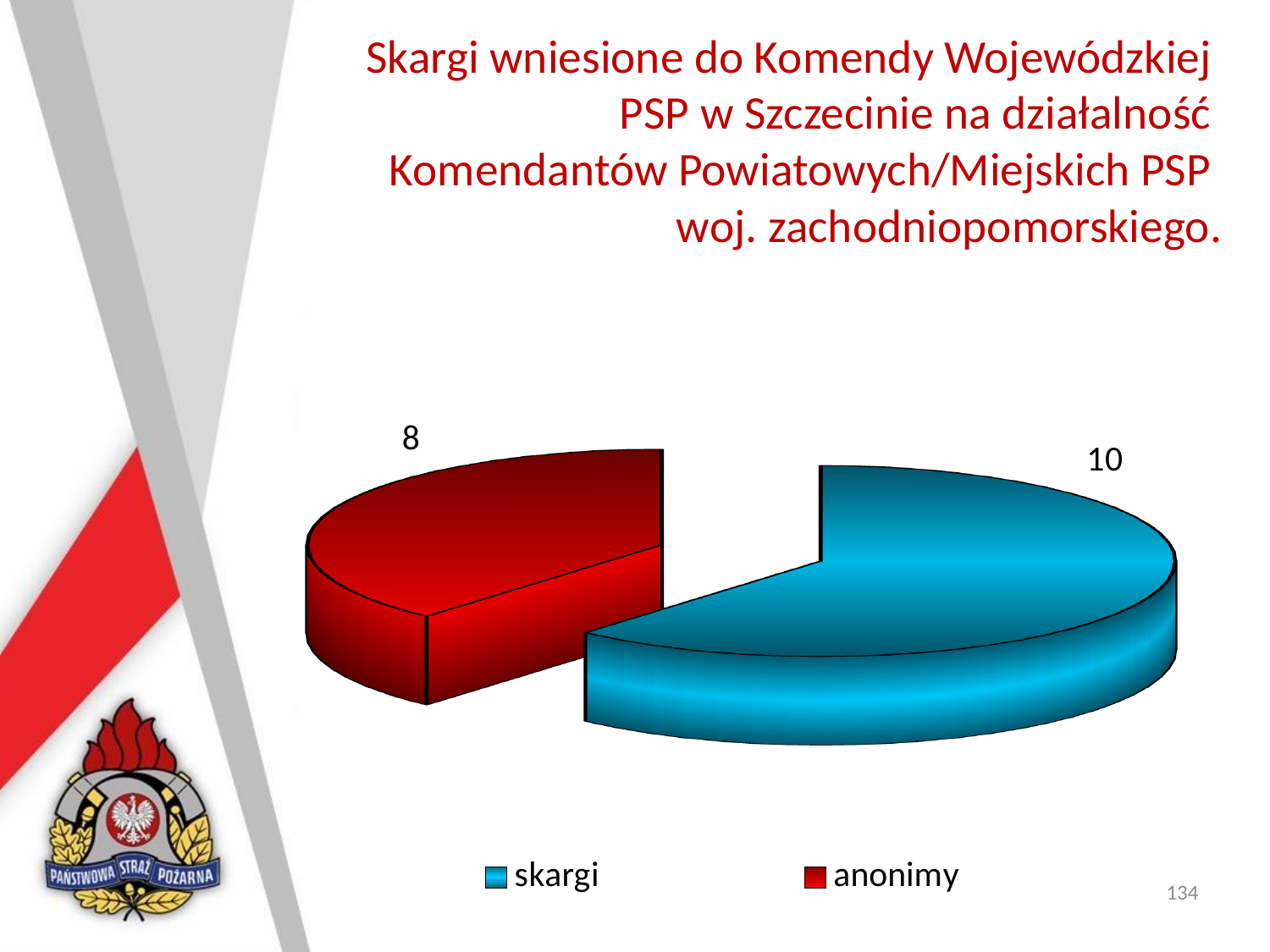
Which is larger, skargi or anonimy? skargi What is the difference between the values for skargi and anonimy? 2 How many slices does the pie chart have? 2 What colour is the slice for anonimy? red What is the value for skargi? 10 Which category has the largest slice? skargi How many entries does the legend list? 2 What colour is the slice for skargi? blue What is the value for anonimy? 8 What kind of chart is shown on the slide? pie chart What is the total of all slices in the pie chart? 18 Which category has the smallest slice? anonimy